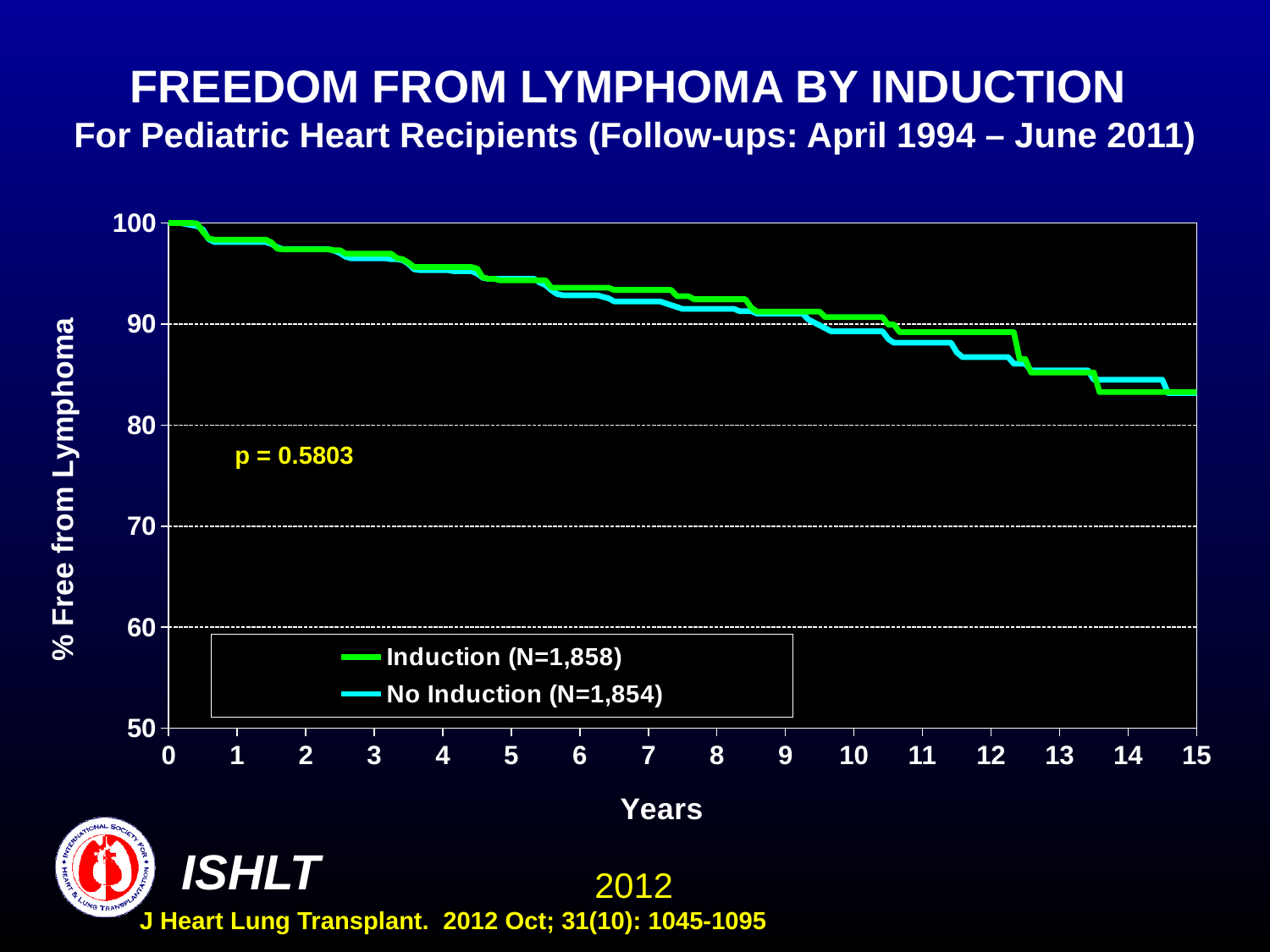
Is the value for Induction at 5 years greater or less than 90? greater Is the value for Induction at 14 years greater or less than 80? greater How many series does the legend list? 2 What is the maximum value shown on the x axis (Years)? 15 Do the values for the Induction series rise or fall as years increase? Fall Is the value for No Induction at 12 years greater or less than 90? less What is the sample size (N) for the Induction group shown in the legend? N=1,858 What kind of chart is shown on the slide? Line chart What is the minimum value shown on the y axis? 50 What p-value is printed on the chart? p = 0.5803 At 12 years, which series has the higher value, Induction or No Induction? Induction